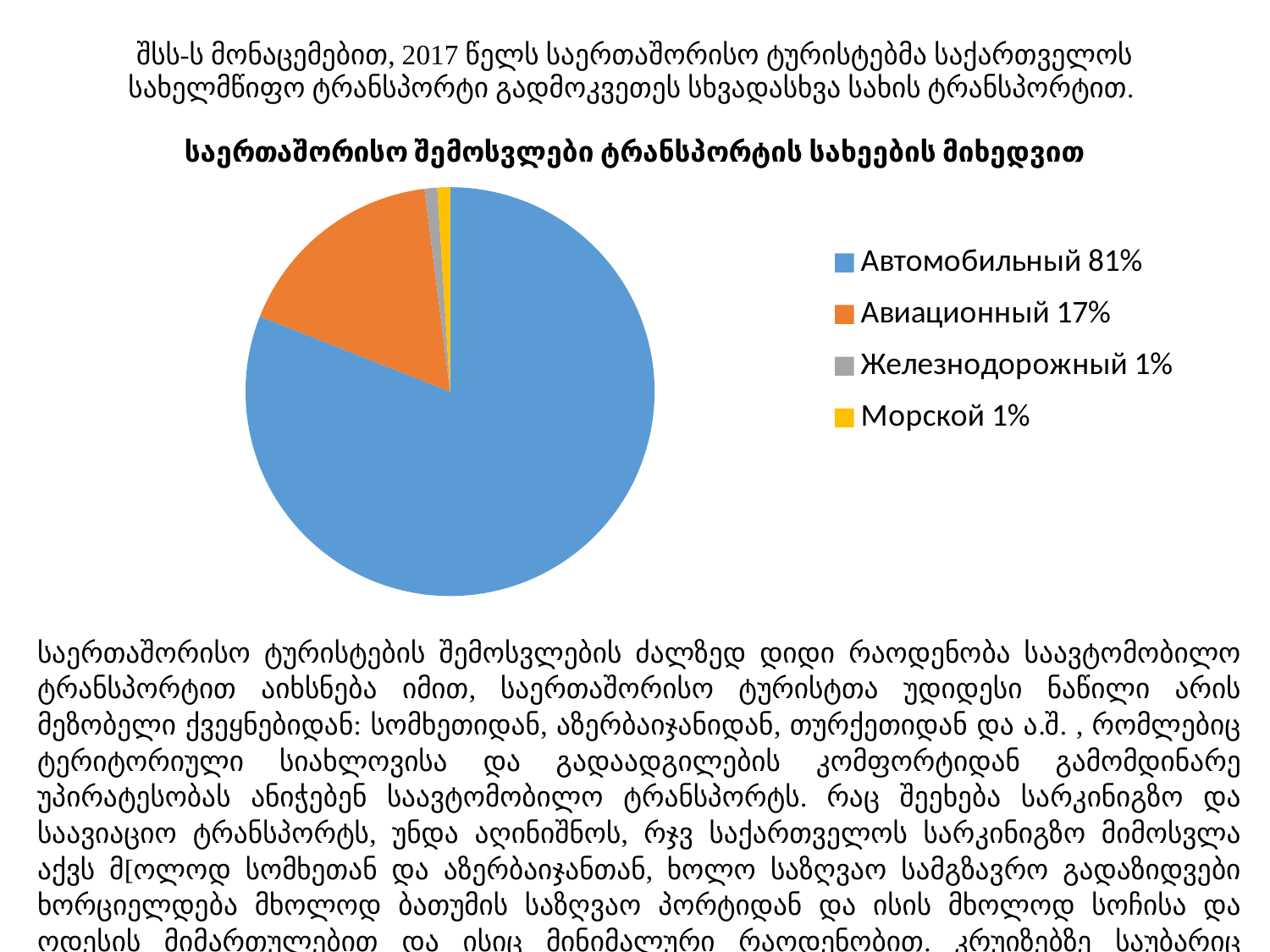
What colour is the slice for Авиационный? orange Which is larger, the share for Автомобильный or the share for Авиационный? Автомобильный What is the value shown for Железнодорожный? 1% What is the value shown for Авиационный? 17% What kind of chart is shown on the slide? pie chart How many entries does the legend list? 4 What is the difference in percentage points between Автомобильный and Авиационный? 64 What colour is the slice for Морской? yellow How many categories does the pie chart show? 4 What is the value shown for Морской? 1% Which category has the largest slice of the pie? Автомобильный What share of the pie does Автомобильный account for? 81%